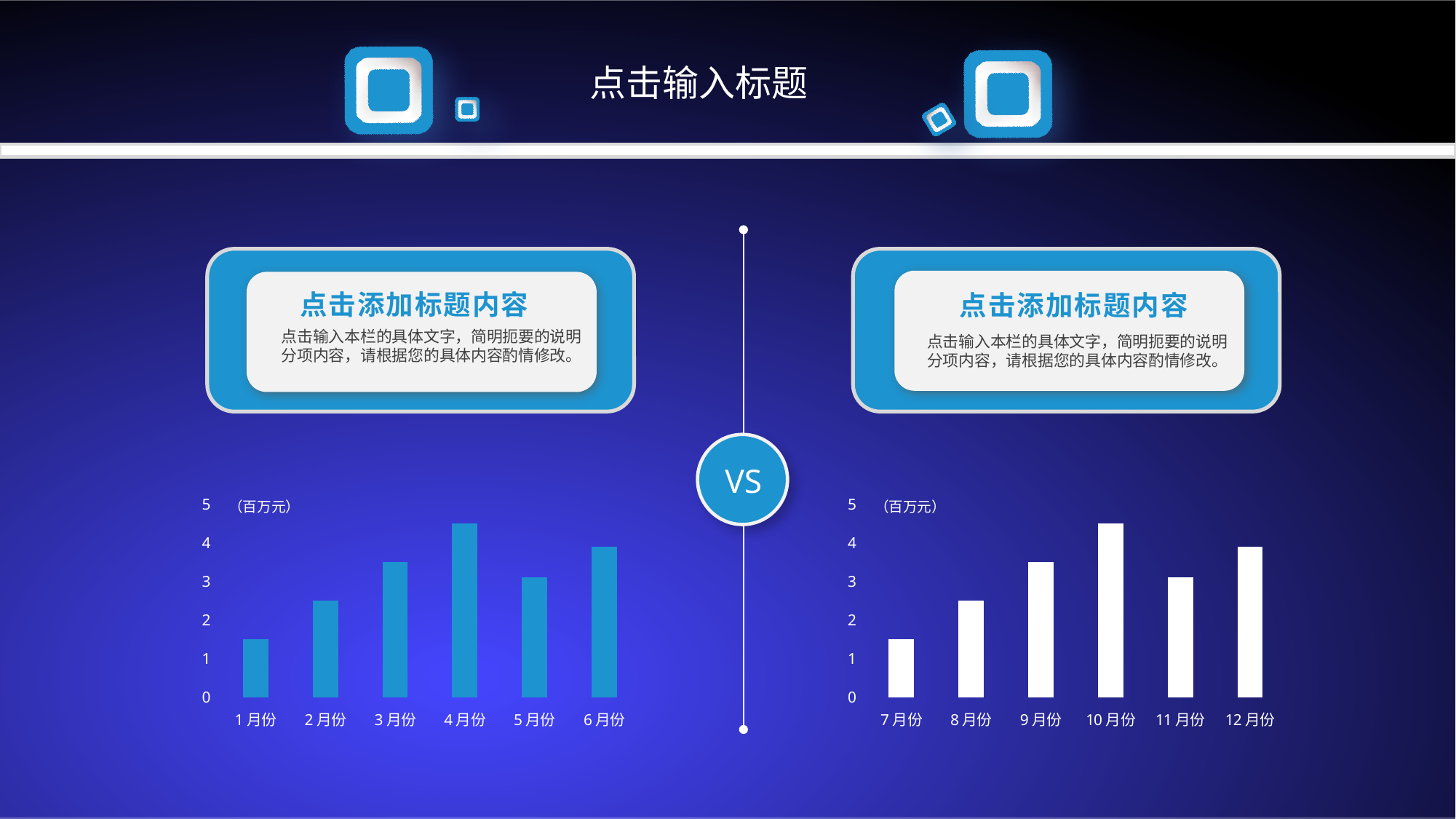
In the right chart, how many bars are plotted? 6 In the left chart, which month has the highest bar? 4月份 In the right chart, is the value for 8月份 greater or less than 3? less What kind of chart is the left chart (1月份 to 6月份)? bar chart What unit is shown next to the y axis of the right chart? 百万元 In the right chart, which month has the lowest bar? 7月份 In the left chart, how many categories (months) are shown on the x axis? 6 In the right chart, which month has the highest bar? 10月份 In the left chart, which month has the lowest bar? 1月份 In the left chart, is the value for 4月份 greater or less than 4? greater What kind of chart is the right chart (7月份 to 12月份)? bar chart In the left chart, which is larger, the value for 3月份 or the value for 2月份? 3月份